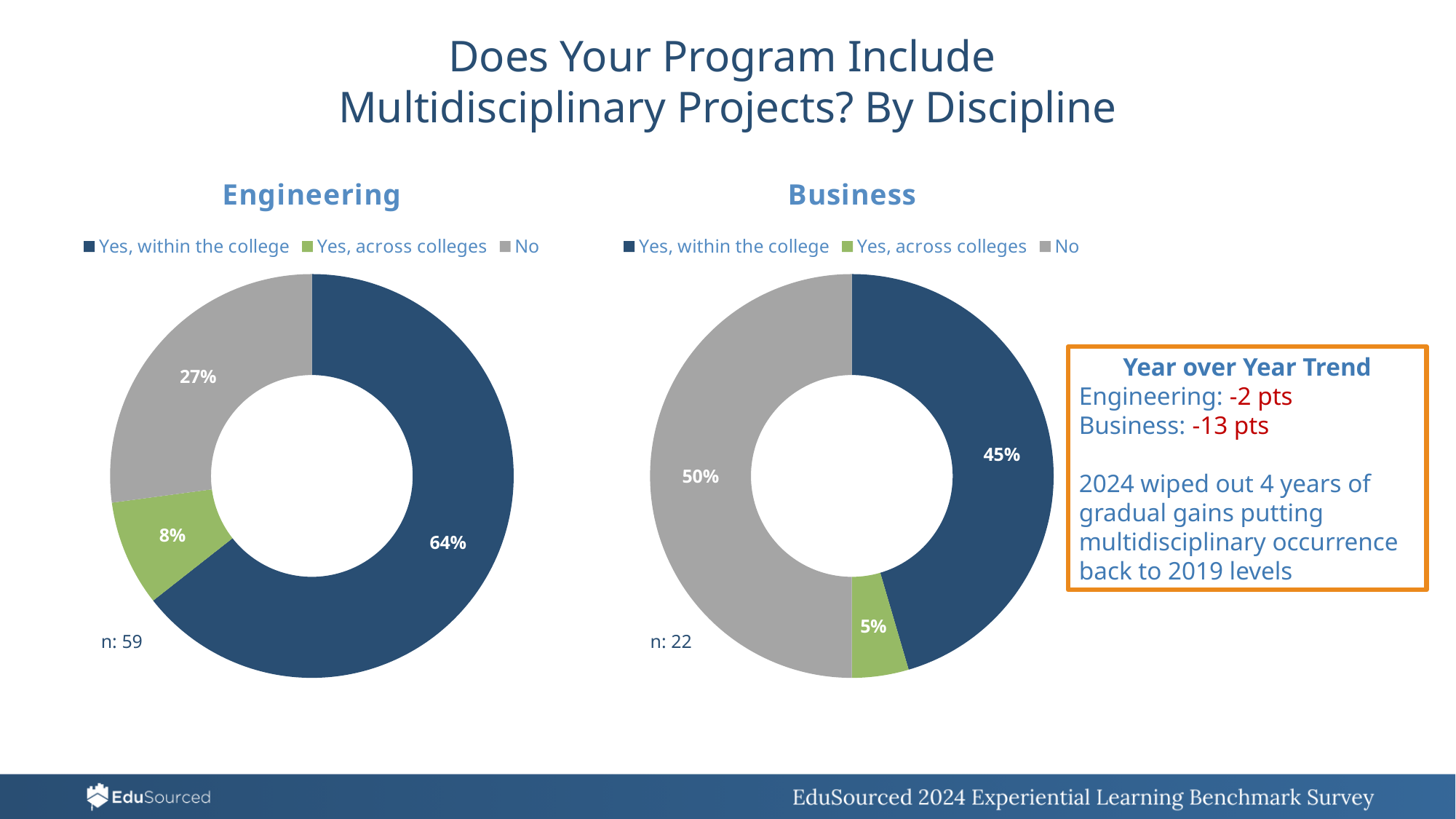
What colour represents "No" in the Business chart? Grey In the Business chart, what percentage answered "Yes, within the college"? 45% In the Business chart, what percentage answered "No"? 50% In the Engineering chart, what percentage answered "Yes, within the college"? 64% Which chart has the larger share for "Yes, within the college", Engineering or Business? Engineering What is the sample size (n) shown for the Engineering chart? 59 What is the difference between the "No" share in the Business chart and the "No" share in the Engineering chart? 23 percentage points What kind of chart is the Business chart? Doughnut (pie) chart In the Engineering chart, what percentage answered "Yes, across colleges"? 8% In the Business chart, which response has the smallest share? Yes, across colleges In the Engineering chart, which response has the largest share? Yes, within the college How many categories does the Engineering chart show? 3